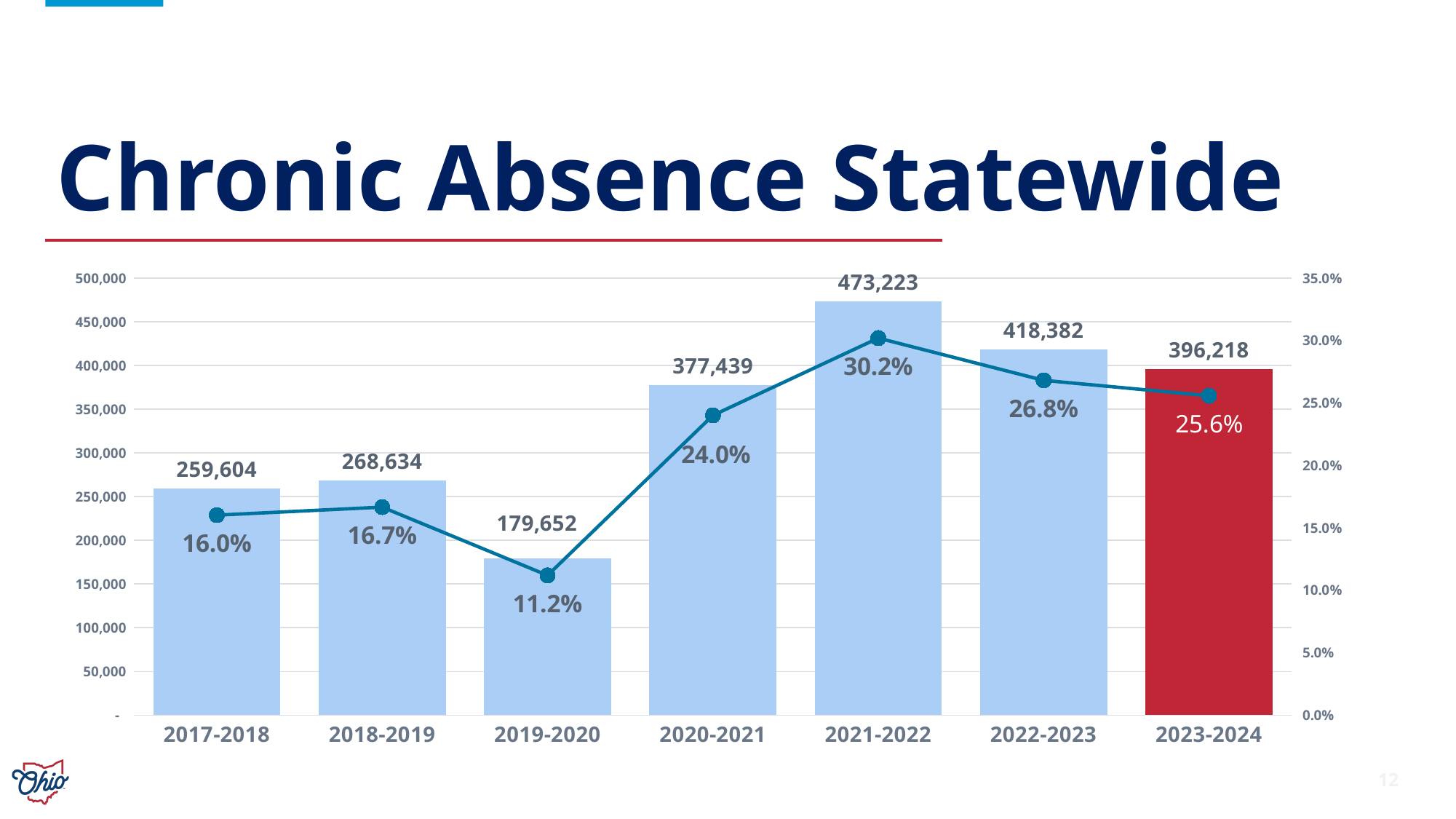
How many school years are shown on the x axis? 7 What percentage is shown on the line for 2019-2020? 11.2% Which bar is coloured red instead of light blue? 2023-2024 Which is larger, the bar value for 2017-2018 or for 2018-2019? 2018-2019 Which school year has the lowest percentage on the line? 2019-2020 Is the bar value for 2020-2021 greater or less than 350,000? greater What is the difference between the bar values for 2022-2023 and 2023-2024? 22,164 What is the bar value for 2023-2024? 396,218 What kind of chart is shown on the slide? Combined bar and line chart What is the bar value for 2021-2022? 473,223 Which school year has the highest bar value? 2021-2022 Does the percentage line rise or fall from 2021-2022 to 2023-2024? Fall